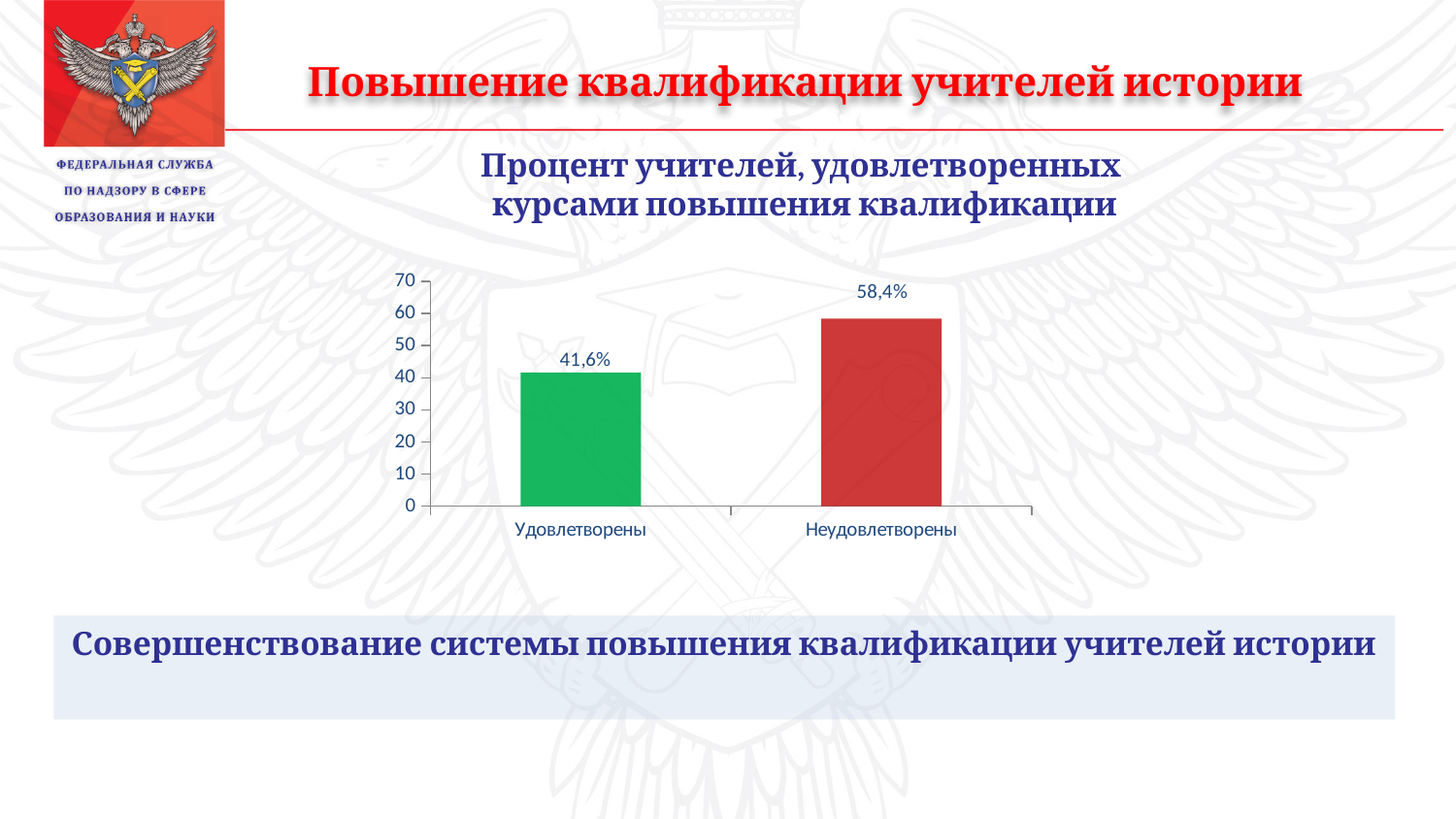
Which category has the highest value? Неудовлетворены What kind of chart is shown on the slide? bar chart Is the value for Неудовлетворены greater or less than 50? greater What is the value for Неудовлетворены? 58,4% Which category has the lowest value? Удовлетворены What is the title of the chart? Процент учителей, удовлетворенных курсами повышения квалификации What is the value for Удовлетворены? 41,6% How many categories are shown on the x axis? 2 Which is larger, the value for Удовлетворены or the value for Неудовлетворены? Неудовлетворены What is the difference between the values for Неудовлетворены and Удовлетворены? 16,8% What colour is the bar for Удовлетворены? green Is the value for Удовлетворены greater or less than 50? less